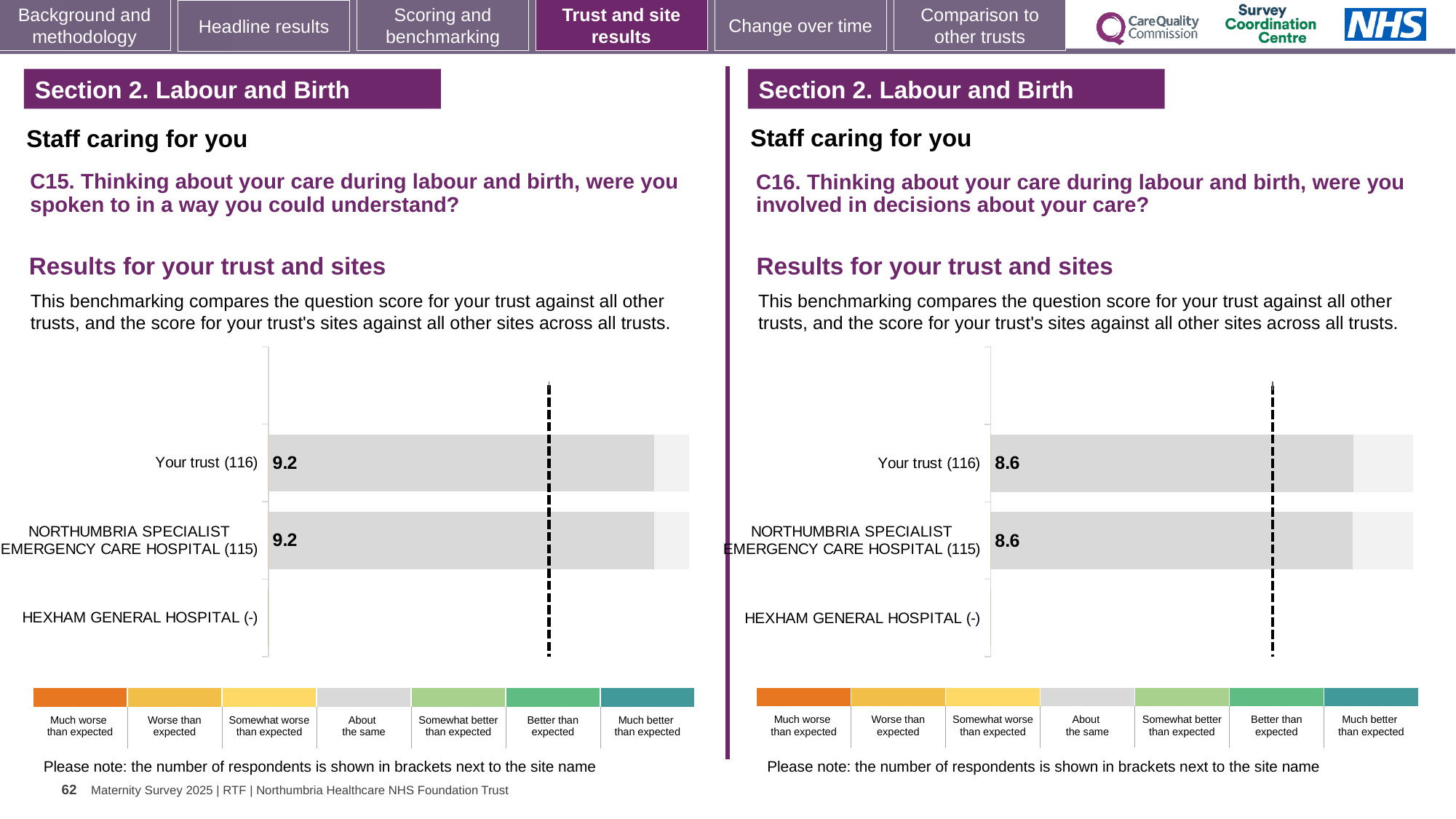
In the C16 chart on the right, which category has no bar plotted? Hexham General Hospital (-) How many site/trust categories are listed on the y axis of the C15 chart on the left? 3 In the C16 chart on the right, what is the score for Your trust (116)? 8.6 What kind of chart is used for the C15 results on the left? Bar chart How many site/trust categories are listed on the y axis of the C16 chart on the right? 3 In the C16 chart on the right, what is the score for Northumbria Specialist Emergency Care Hospital (115)? 8.6 In the C15 chart on the left, what is the difference between the score for Your trust (116) and the score for Northumbria Specialist Emergency Care Hospital (115)? 0 In the C16 chart on the right, what is the difference between the score for Your trust (116) and the score for Northumbria Specialist Emergency Care Hospital (115)? 0 In the C15 chart on the left, what is the score for Northumbria Specialist Emergency Care Hospital (115)? 9.2 In the C15 chart on the left, what is the score for Your trust (116)? 9.2 How many respondents are shown in brackets for Your trust in the C15 chart on the left? 116